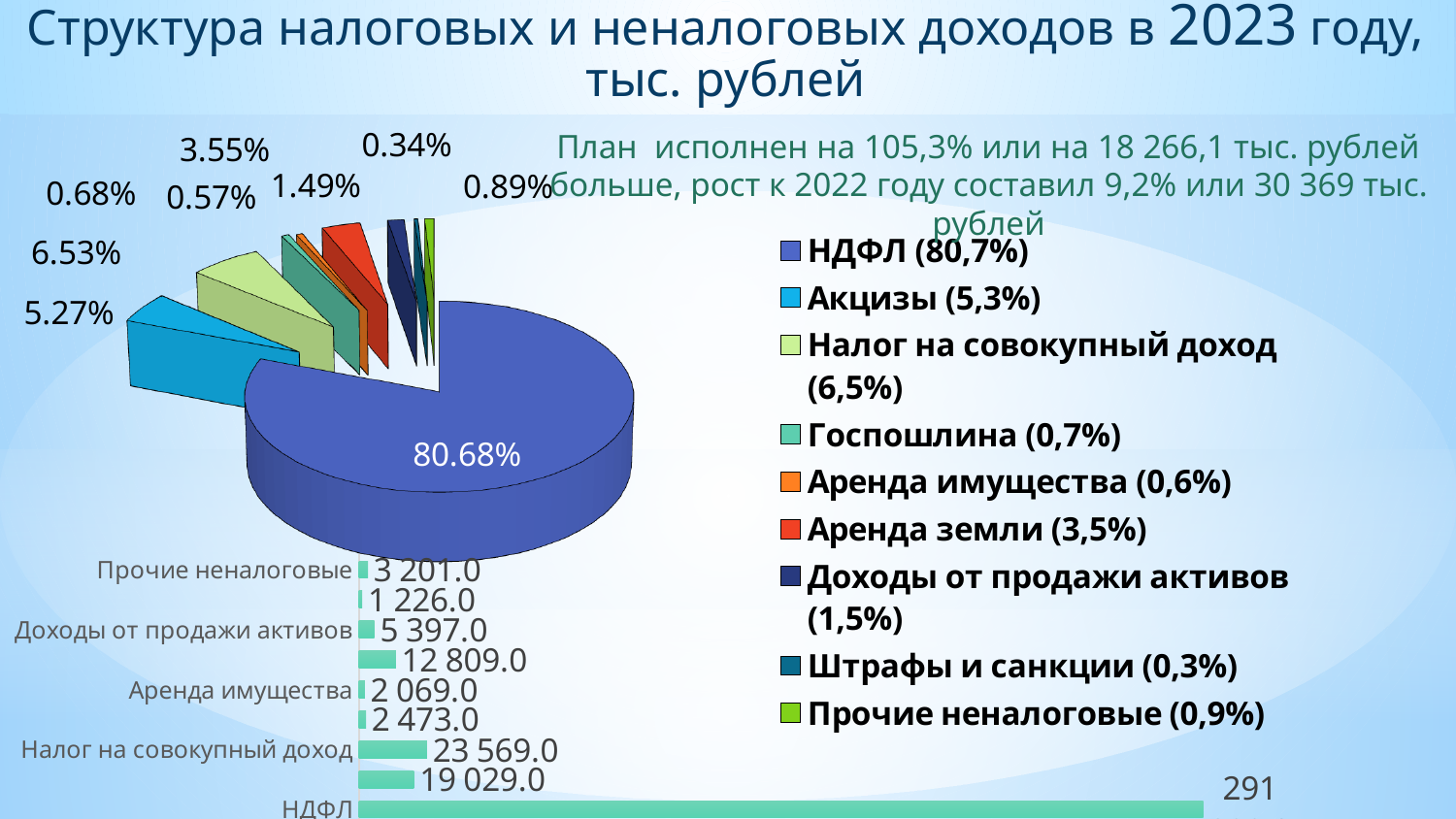
In the bar chart at the bottom of the slide, what is the value for Доходы от продажи активов? 5 397.0 What kind of chart is the chart at the bottom of the slide? Bar chart In the bar chart at the bottom of the slide, what is the difference between the values for Доходы от продажи активов and Аренда имущества? 3 328.0 In the bar chart at the bottom of the slide, what is the value for Аренда имущества? 2 069.0 In the bar chart at the bottom of the slide, what is the value for Налог на совокупный доход? 23 569.0 In the pie chart legend, what percentage is given for Акцизы? 5,3% In the pie chart, what percentage is shown on the НДФЛ slice? 80.68% In the pie chart, which category has the largest slice? НДФЛ In the bar chart at the bottom of the slide, which is larger: Налог на совокупный доход or Прочие неналоговые? Налог на совокупный доход How many entries does the pie chart's legend list? 9 What kind of chart is the chart in the upper left of the slide? Pie chart In the bar chart at the bottom of the slide, what is the value for Прочие неналоговые? 3 201.0